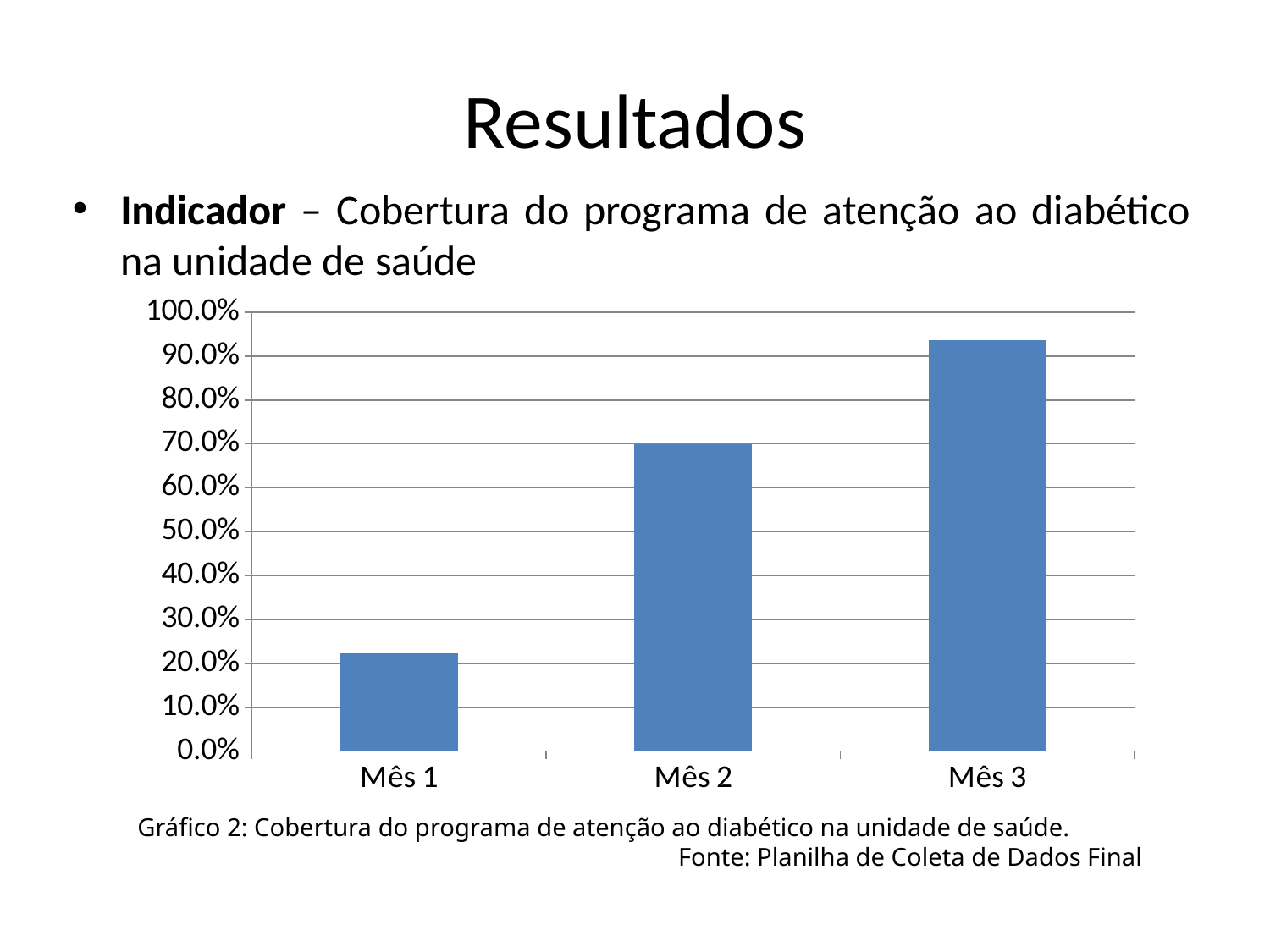
Which is larger, the value for Mês 2 or the value for Mês 3? Mês 3 Which month has the highest coverage value in the chart? Mês 3 Is the value for Mês 1 greater or less than 10.0%? greater Is the value for Mês 3 greater or less than 90.0%? greater Is the value for Mês 1 greater or less than 30.0%? less What is the caption given below the chart (Gráfico 2)? Cobertura do programa de atenção ao diabético na unidade de saúde. Which month has the lowest coverage value in the chart? Mês 1 Do the values rise or fall from Mês 1 to Mês 3? rise How many categories (months) are shown on the x axis of the chart? 3 What kind of chart is shown on the slide? bar chart